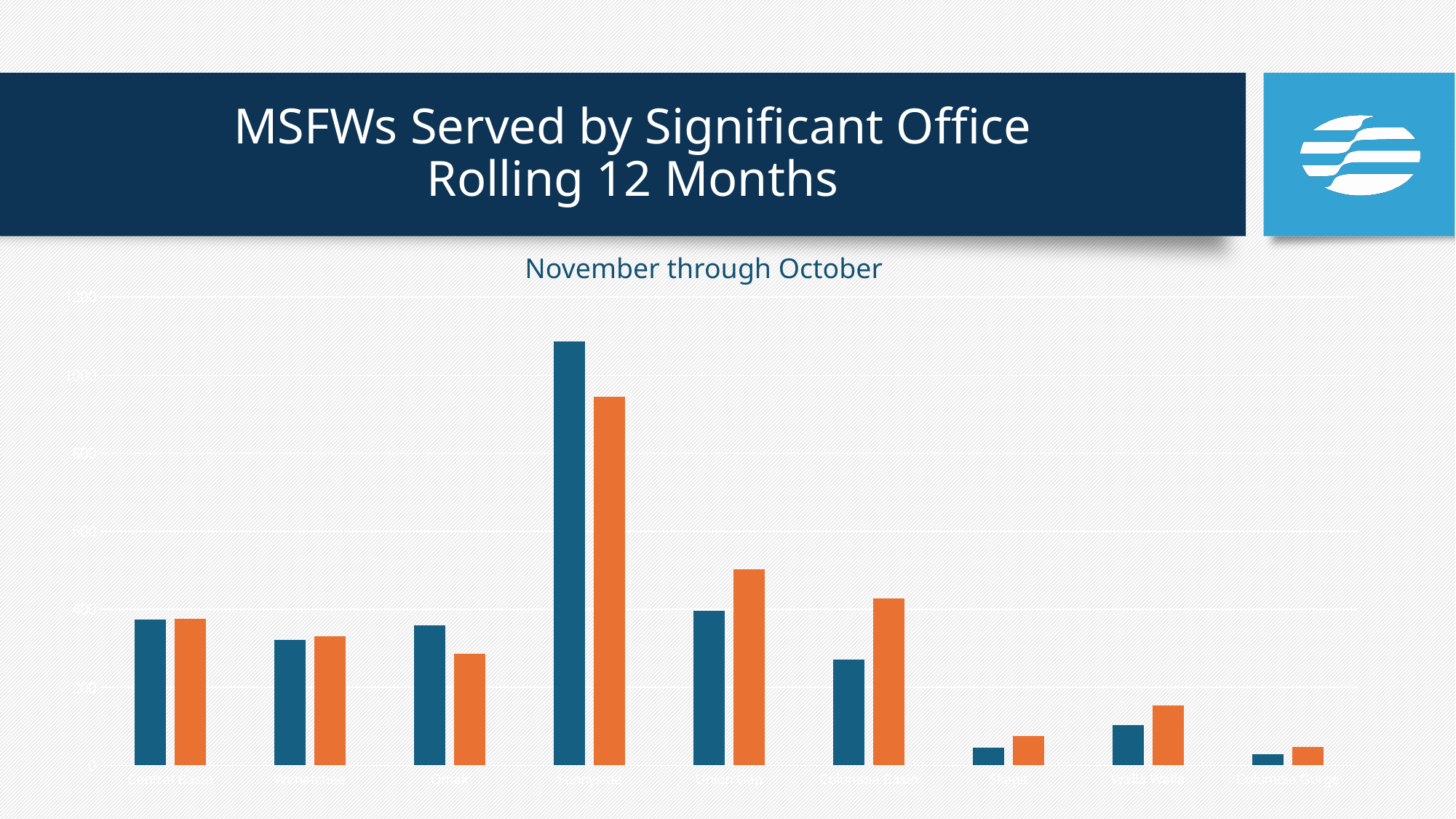
What is the title shown directly above the chart? November through October Is the orange bar in the fourth category group from the left greater or less than 1,000? less Which category group, counted from the left, has the tallest bars in the chart? the fourth group In the fifth category group from the left, which bar is taller, the blue bar or the orange bar? the orange bar Is the blue bar in the fourth category group from the left greater or less than 1,000? greater Is the blue bar in the seventh category group from the left greater or less than 200? less How many bars are plotted for each category group in the chart? 2 What two colours are used for the bars in the chart? blue and orange How many category groups are plotted along the x axis of the chart? 9 What kind of chart is shown on the slide? bar chart In the fourth category group from the left, which bar is taller, the blue bar or the orange bar? the blue bar